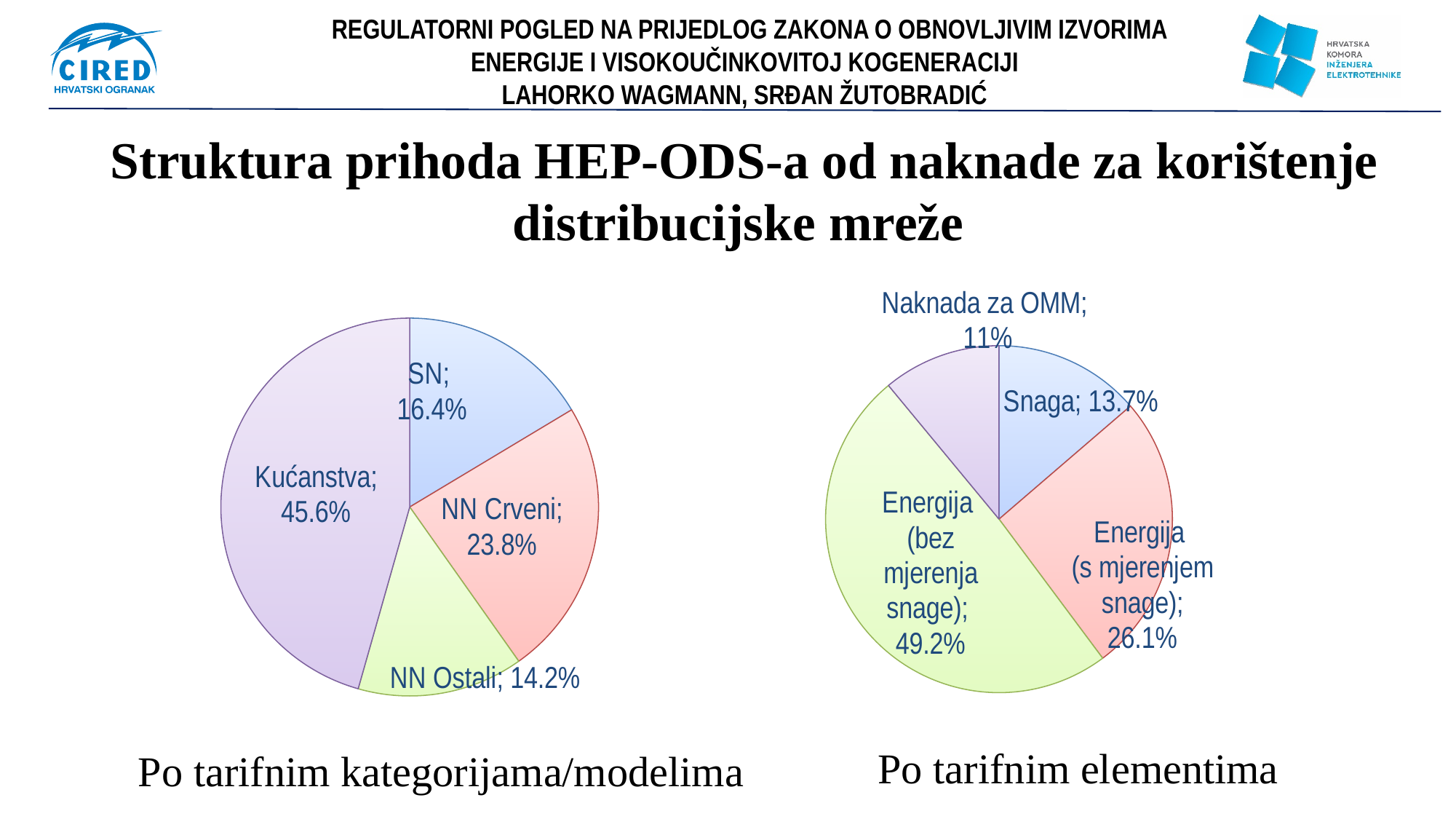
In the left pie chart (Po tarifnim kategorijama/modelima), which category has the largest share? Kućanstva In the left pie chart (Po tarifnim kategorijama/modelima), what share does Kućanstva have? 45.6% What type of chart is used on the left side of the slide? Pie chart In the right pie chart (Po tarifnim elementima), what is the difference between Energija (bez mjerenja snage) and Energija (s mjerenjem snage)? 23.1% In the right pie chart (Po tarifnim elementima), which is larger: Snaga or Naknada za OMM? Snaga In the right pie chart (Po tarifnim elementima), what share does Energija (s mjerenjem snage) have? 26.1% In the left pie chart (Po tarifnim kategorijama/modelima), what is the difference between the shares of NN Crveni and SN? 7.4% In the right pie chart (Po tarifnim elementima), which element has the largest share? Energija (bez mjerenja snage) In the right pie chart (Po tarifnim elementima), what is the value for Naknada za OMM? 11% In the left pie chart (Po tarifnim kategorijama/modelima), which category has the smallest share? NN Ostali In the left pie chart (Po tarifnim kategorijama/modelima), how many slices are there? 4 In the left pie chart (Po tarifnim kategorijama/modelima), what is the value for NN Crveni? 23.8%